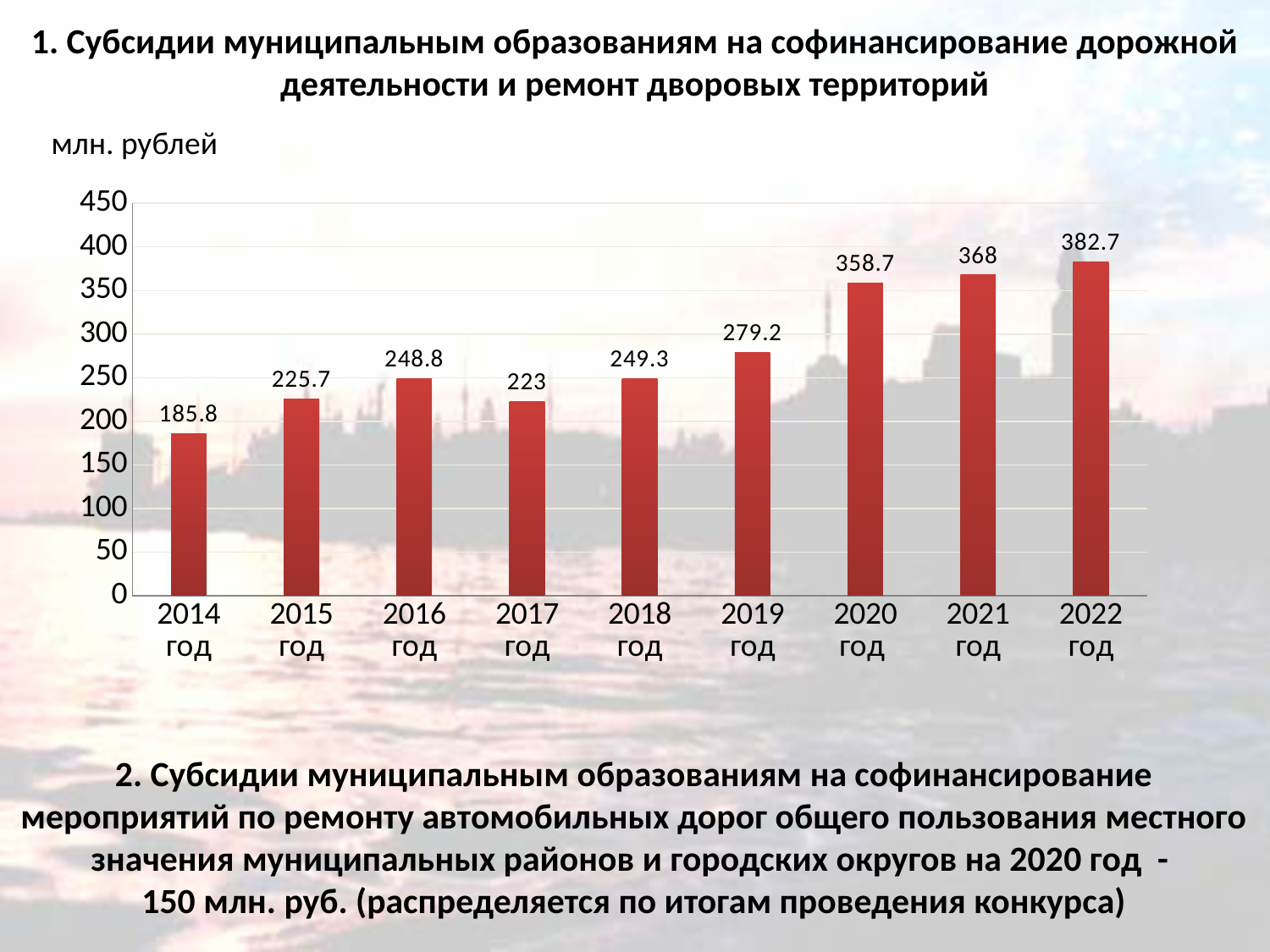
What is the value for 2017 год? 223 How many years are shown on the x axis? 9 What kind of chart is shown on the slide? bar chart Is the value for 2020 год greater or less than 300? greater Which is larger, the value for 2016 год or the value for 2017 год? 2016 год What is the value for 2019 год? 279.2 What is the difference between the values for 2022 год and 2014 год? 196.9 What is the value for 2014 год? 185.8 What unit is indicated for the values on the chart? млн. рублей What is the difference between the values for 2021 год and 2020 год? 9.3 Which year has the lowest value? 2014 год Which year has the highest value? 2022 год